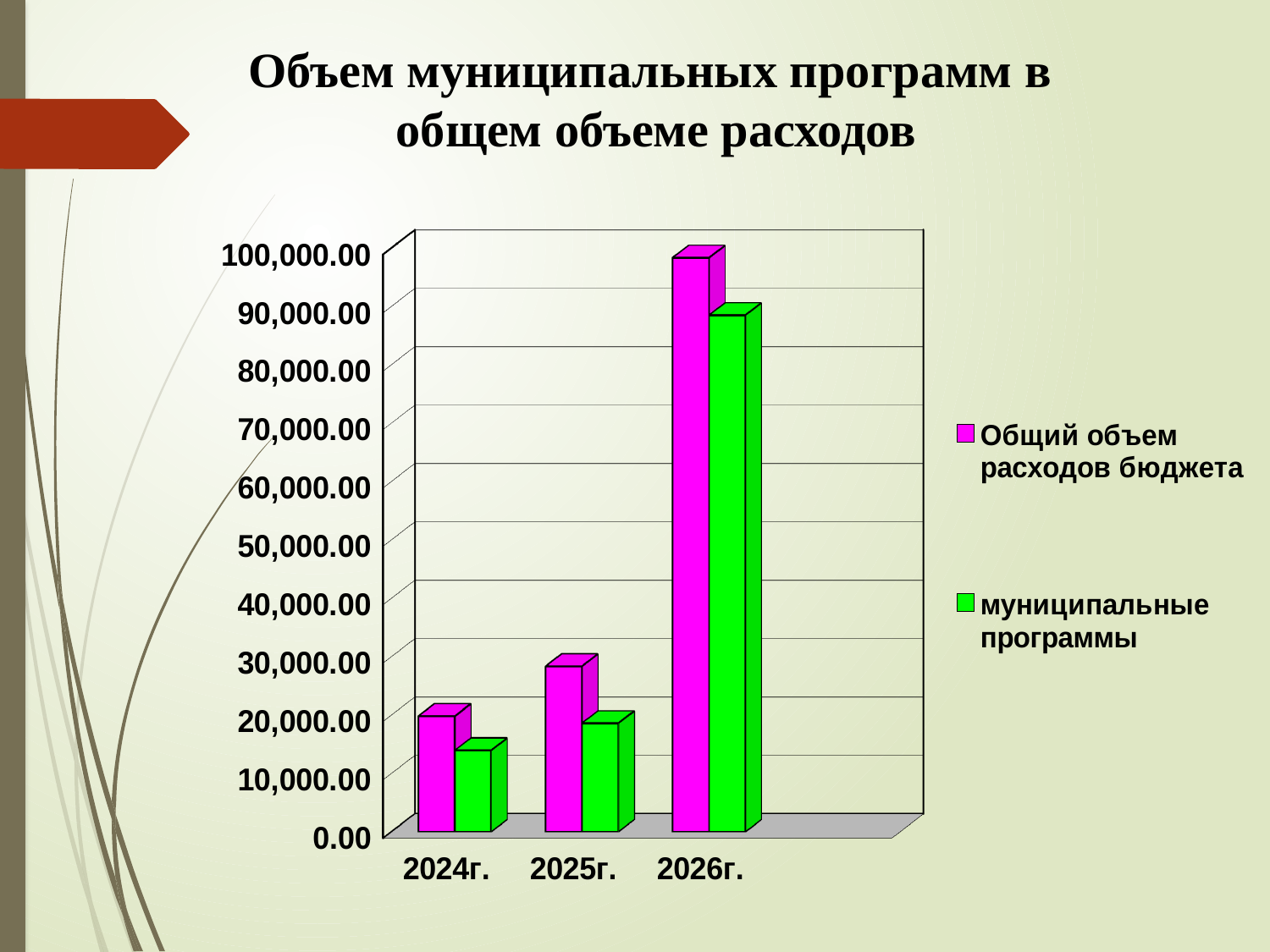
In 2026г., which is larger: Общий объем расходов бюджета or муниципальные программы? Общий объем расходов бюджета Is the value for Общий объем расходов бюджета in 2026г. greater or less than 90,000.00? greater What colour represents муниципальные программы in the chart? green Is the value for муниципальные программы in 2024г. greater or less than 10,000.00? greater Is the value for Общий объем расходов бюджета in 2025г. greater or less than 40,000.00? less Do the values for Общий объем расходов бюджета rise or fall from 2024г. to 2026г.? rise What kind of chart is shown on the slide? bar chart Which year has the lowest value for муниципальные программы? 2024г. Which year has the highest value for Общий объем расходов бюджета? 2026г. How many year categories are shown on the x axis? 3 How many series does the legend list? 2